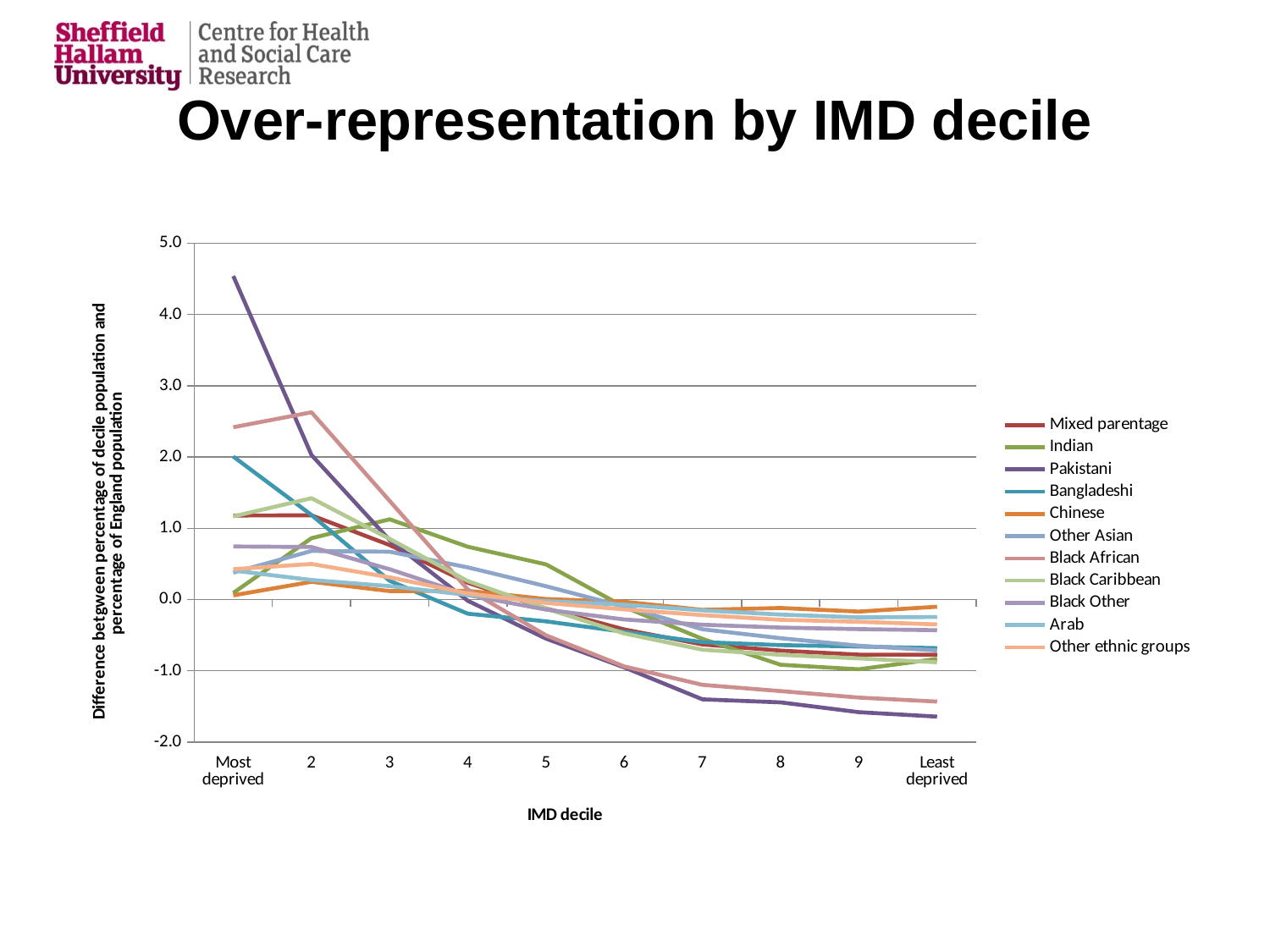
How many IMD decile categories are shown along the x axis? 10 Is the value for Pakistani at the Least deprived decile greater or less than -1.0? less Is the value for Pakistani at the Most deprived decile greater or less than 4.0? greater Does the Pakistani line rise or fall from the Most deprived decile to the Least deprived decile? fall Is the value for Black African at decile 2 greater or less than 2.0? greater At the Most deprived decile, which is larger: the value for Pakistani or the value for Black African? Pakistani What kind of chart is shown on the slide? line chart How many series does the legend list? 11 What is the title of the chart on the slide? Over-representation by IMD decile Which ethnic group has the highest value at the Most deprived decile? Pakistani Which ethnic group has the lowest value at the Least deprived decile? Pakistani